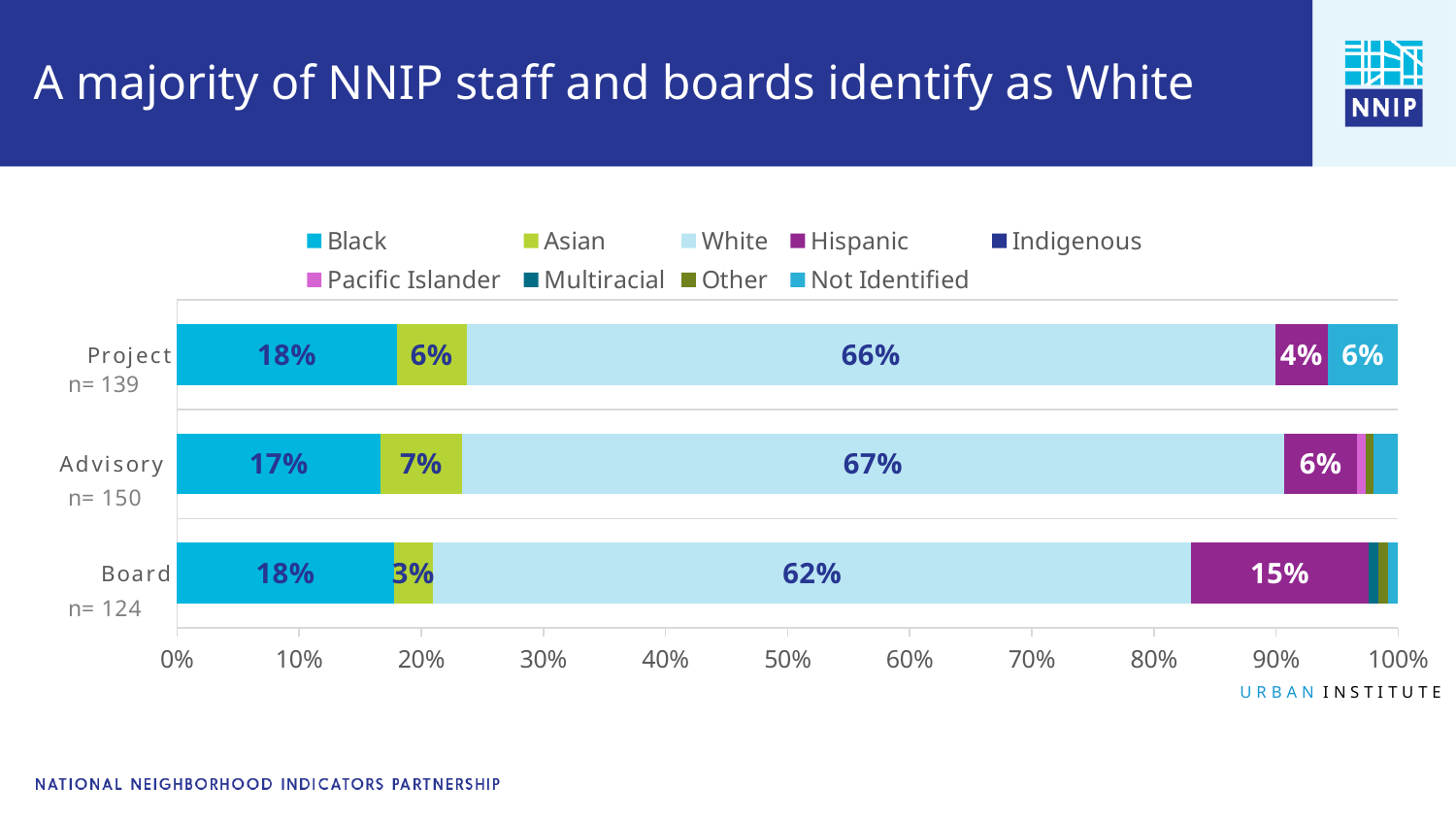
Which group has the highest share identifying as White? Advisory What percentage of the Project group identifies as White? 66% What percentage of the Advisory group identifies as Black? 17% Which group has a larger Asian share, Project or Advisory? Advisory Is the White share for the Board group greater or less than 50%? greater Which group has the highest share identifying as Hispanic? Board What percentage of the Board group identifies as Hispanic? 15% What percentage of the Board group identifies as Asian? 3% How many groups are shown as bars in the chart? 3 What kind of chart is shown on the slide? Stacked bar chart What is the difference between the White share of the Advisory group and the White share of the Board group? 5 percentage points How many series does the legend list? 9